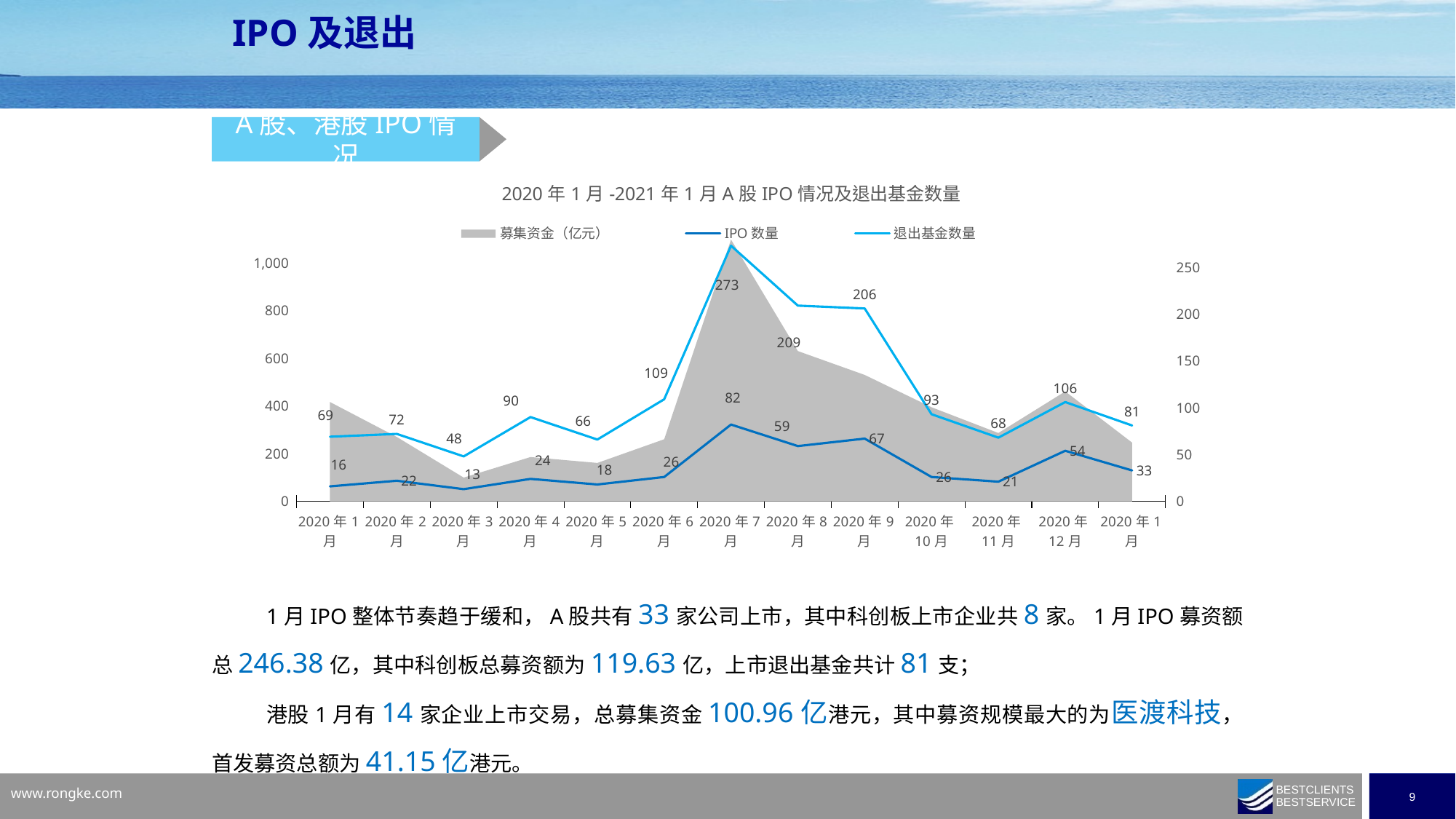
How many series does the chart legend list? 3 What is the difference between 退出基金数量 in 2020年7月 and 2020年8月? 64 How many months are plotted along the x axis of the chart? 13 Which month has a larger 退出基金数量, 2020年4月 or 2020年5月? 2020年4月 Does 退出基金数量 rise or fall from 2020年7月 to 2020年11月? fall Is the value of 募集资金（亿元） in 2020年7月 greater or less than 800? greater In which month is IPO数量 the highest? 2020年7月 What is the value of 退出基金数量 in 2020年7月? 273 In which month is 退出基金数量 the lowest? 2020年3月 What kind of chart is shown on the slide? A combined area and line chart In which month is IPO数量 the lowest? 2020年3月 What is the value of IPO数量 in 2020年12月? 54